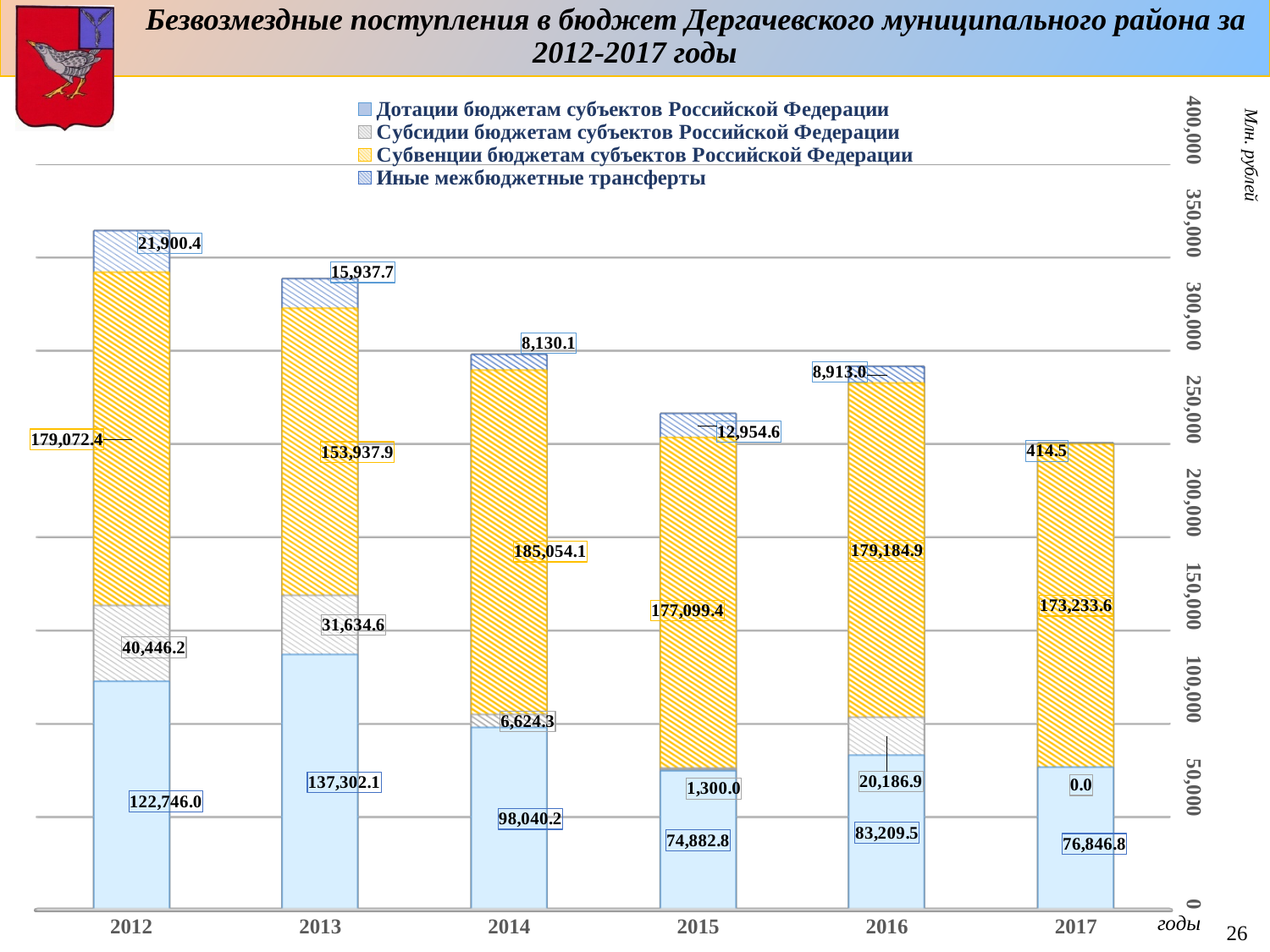
Which year has the larger value of Субсидии бюджетам субъектов Российской Федерации, 2012 or 2016? 2012 What is the value of Иные межбюджетные трансферты for 2015? 12,954.6 How many years are shown on the x axis? 6 What kind of chart is shown on the slide? stacked bar chart In which year is the value of Субсидии бюджетам субъектов Российской Федерации the lowest? 2017 Is the total height of the stacked bar for 2014 greater or less than 250,000? greater What is the value of Дотации бюджетам субъектов Российской Федерации for 2012? 122,746.0 What is the total of the stacked bar for 2017? 250,494.9 In which year is the value of Дотации бюджетам субъектов Российской Федерации the highest? 2013 What is the value of Субвенции бюджетам субъектов Российской Федерации for 2014? 185,054.1 What is the difference between the Дотации бюджетам субъектов Российской Федерации values for 2013 and 2012? 14,556.1 How many series does the legend list? 4